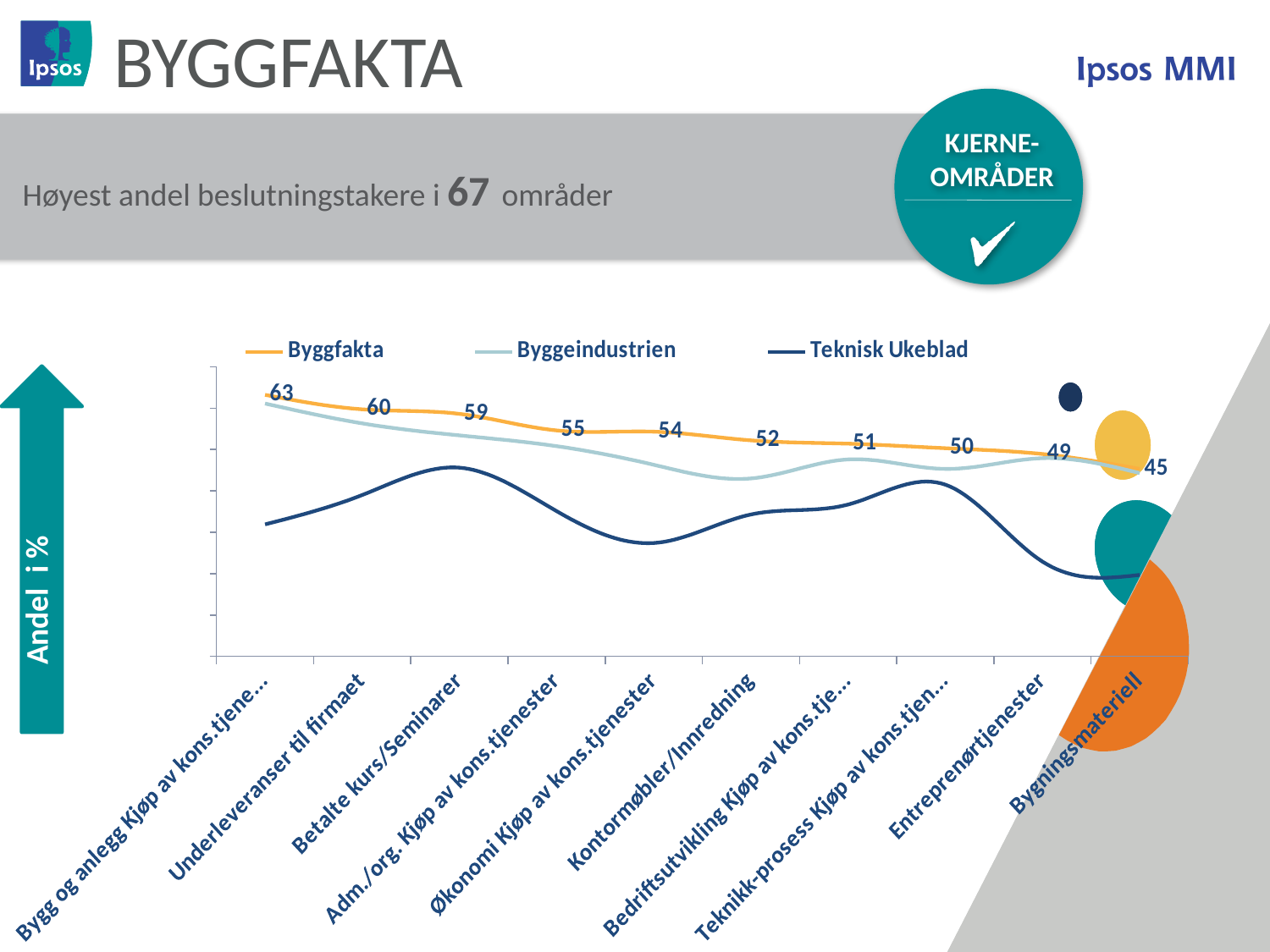
What is the Byggfakta value for Betalte kurs/Seminarer? 59 What is the Byggfakta value for Entreprenørtjenester? 49 How many categories are shown on the x axis? 10 How many series does the legend list? 3 What is the Byggfakta value for Underleveranser til firmaet? 60 What kind of chart is shown on the slide? Line chart What is the Byggfakta value for Bygningsmateriell? 45 For which category is the Byggfakta value lowest? Bygningsmateriell At Betalte kurs/Seminarer, which series has the higher value: Byggfakta or Teknisk Ukeblad? Byggfakta What is the highest labelled value on the Byggfakta line? 63 Does the Byggfakta line rise or fall from left to right along the x axis? Fall What is the difference between the Byggfakta values for Kontormøbler/Innredning and Entreprenørtjenester? 3